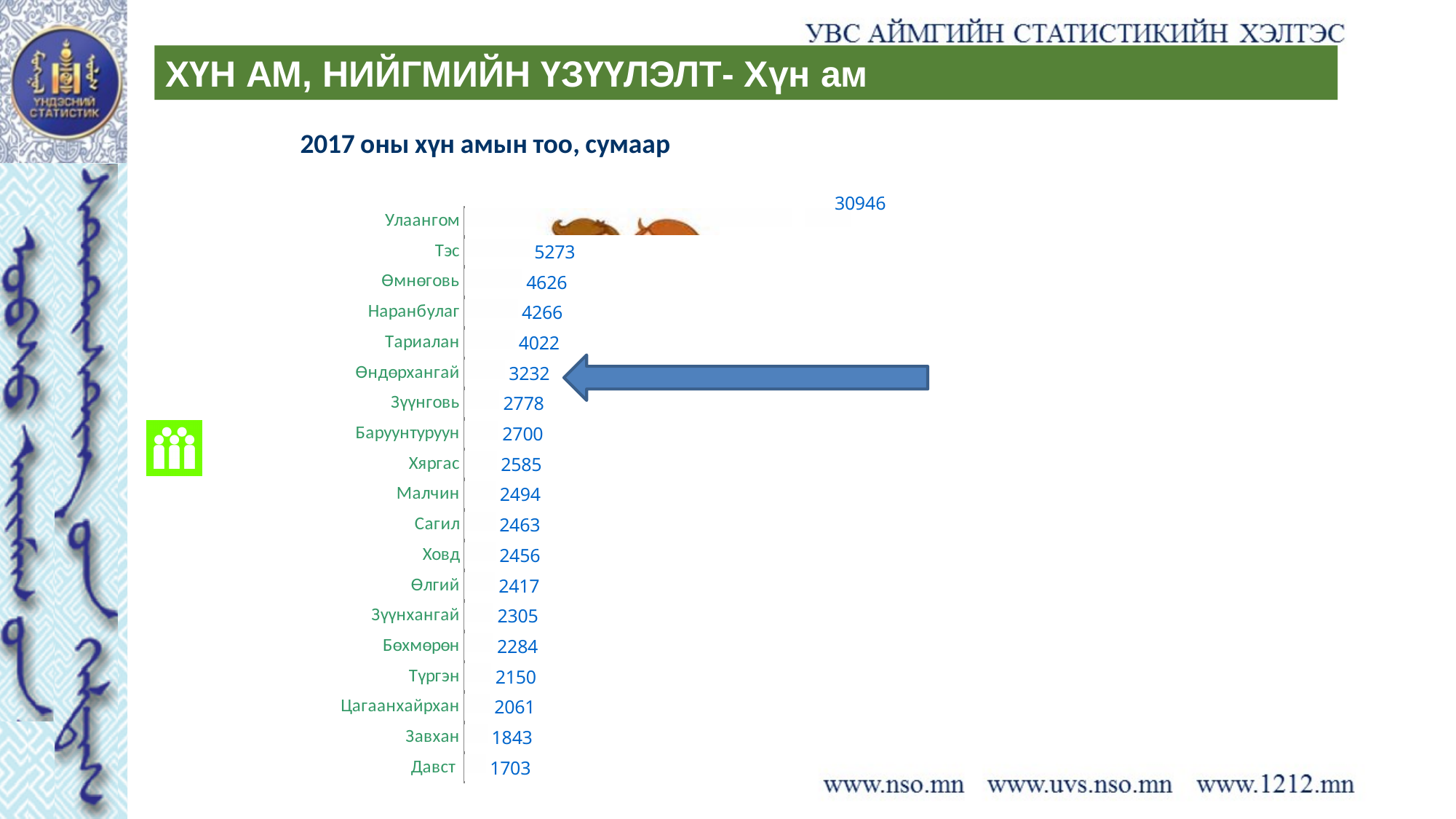
What is the value shown for Өндөрхангай? 3232 What is the title of the chart? 2017 оны хүн амын тоо, сумаар What is the value shown for Улаангом? 30946 Which category has the lowest value? Давст How many categories are shown in the chart? 19 What kind of chart is shown on the slide? Bar chart Which category has the highest value? Улаангом What is the difference between the values for Завхан and Давст? 140 What is the value shown for Тэс? 5273 Which is larger, the value for Наранбулаг or the value for Тариалан? Наранбулаг What is the difference between the values for Тэс and Өмнөговь? 647 What is the value shown for Давст? 1703